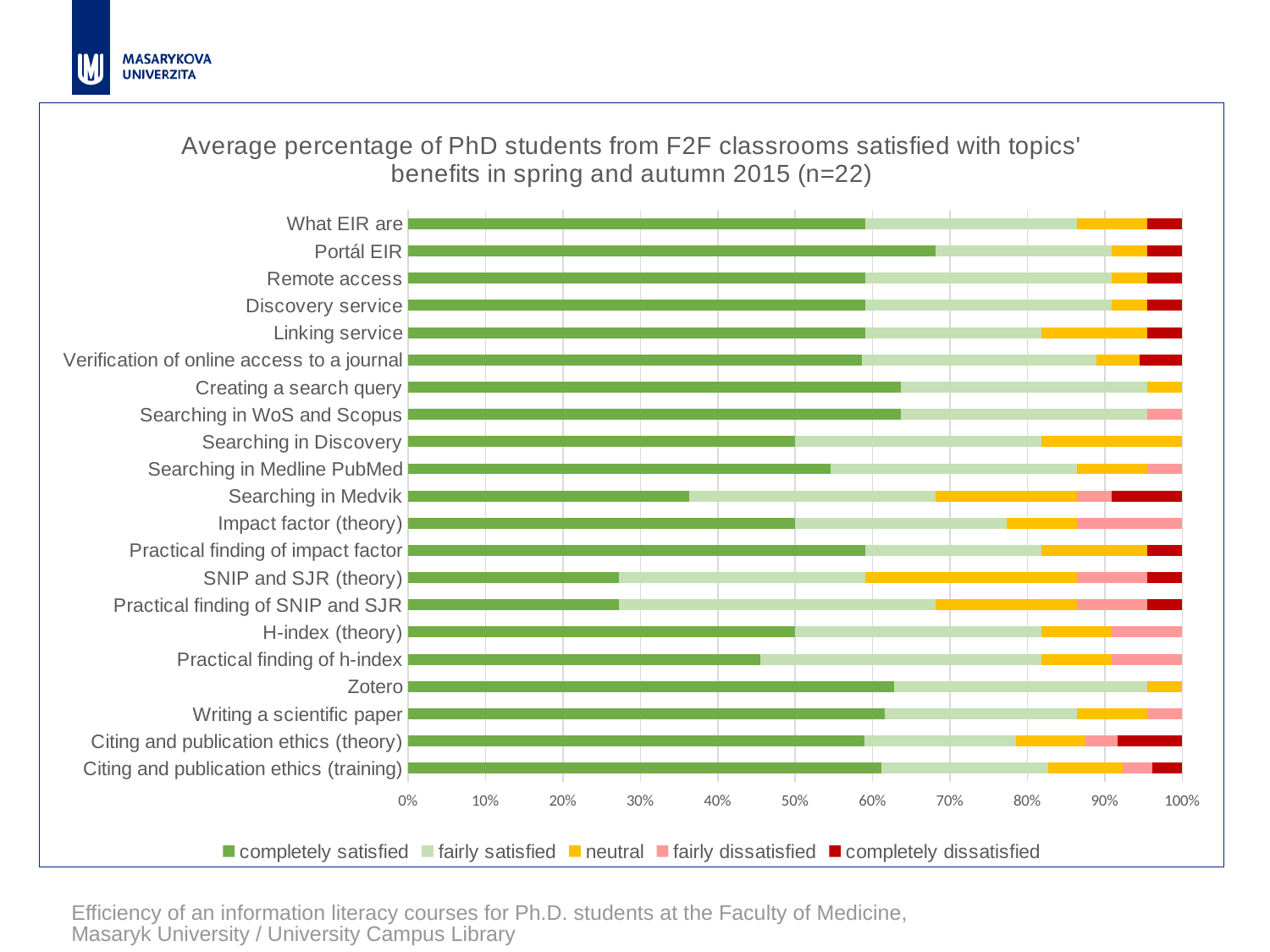
What kind of chart is shown on the slide? stacked bar chart Which topic has the largest 'completely satisfied' share? Portál EIR Which has a larger 'completely satisfied' share: Zotero or Searching in Discovery? Zotero Is the 'completely satisfied' share for Searching in Medvik greater or less than 40%? less What is the sample size (n) stated in the chart title? n=22 How many topics (categories) are listed on the vertical axis of the chart? 21 What do the segments of each stacked bar add up to? 100% Is the 'completely satisfied' share for Portál EIR greater or less than 60%? greater Is the 'completely satisfied' share for SNIP and SJR (theory) greater or less than 30%? less Which legend entry is shown in dark red? completely dissatisfied How many series does the chart legend list? 5 Which has a larger 'completely satisfied' share: Creating a search query or Practical finding of h-index? Creating a search query